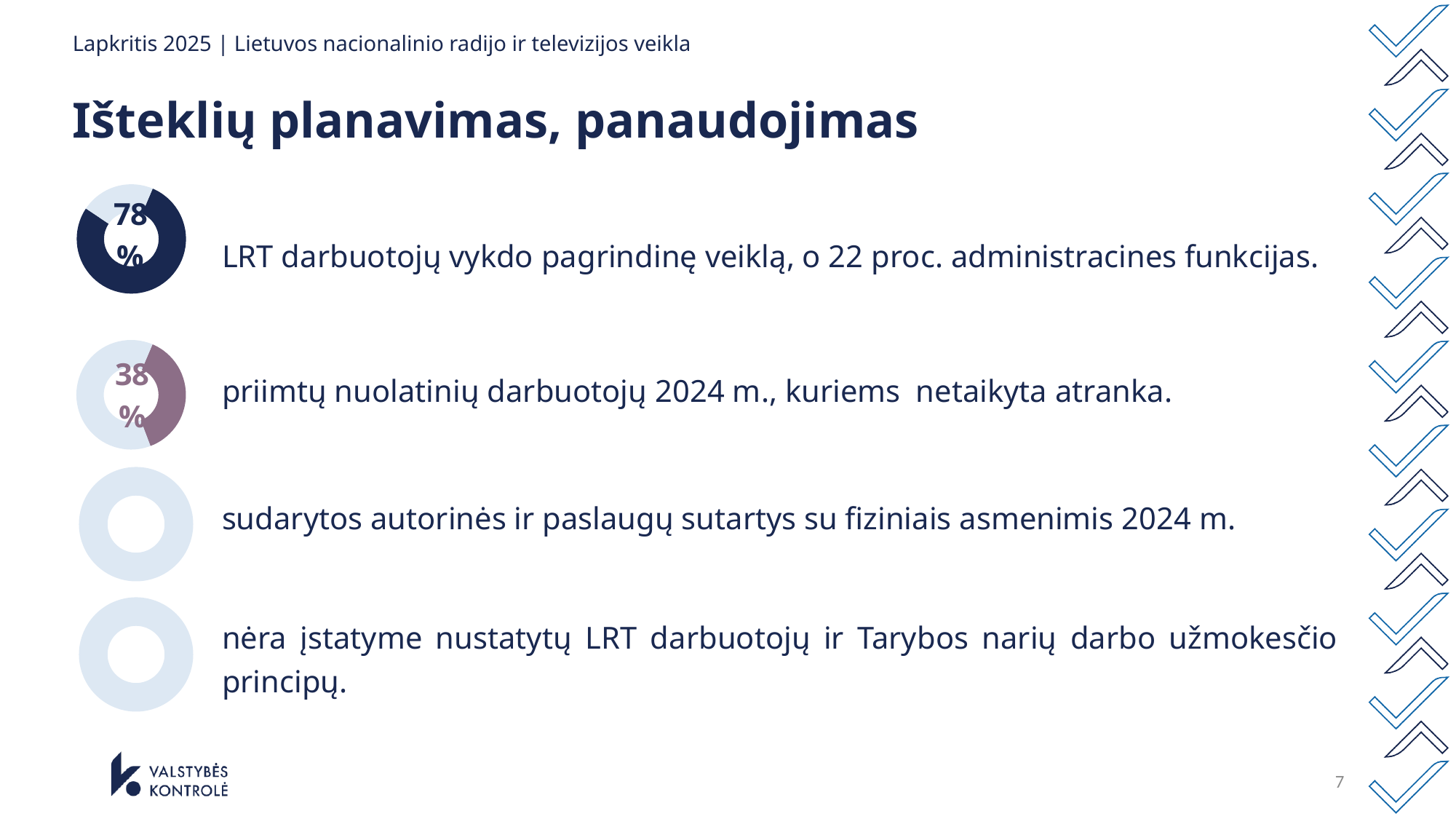
What colour is the filled segment in the first doughnut chart (78%)? Dark navy blue What share of the first doughnut chart is filled with the dark segment? 78% Is the value shown in the first doughnut chart greater or less than 50%? greater What is the difference between the value in the first doughnut chart and the value in the second doughnut chart? 40 percentage points What kind of chart is used next to the first bullet point on the slide? Doughnut (pie) chart What colour is the filled segment in the second doughnut chart (38%)? Purple (mauve) What value is shown in the first (top) doughnut chart? 78% How many doughnut charts are shown on the slide in total? 4 Which doughnut chart shows the larger value, the first (top) one or the second one? The first (top) one How many of the doughnut charts on the slide display a percentage value? 2 Is the value shown in the second doughnut chart greater or less than 50%? less What value is shown in the second doughnut chart, next to the bullet about permanent employees hired in 2024? 38%